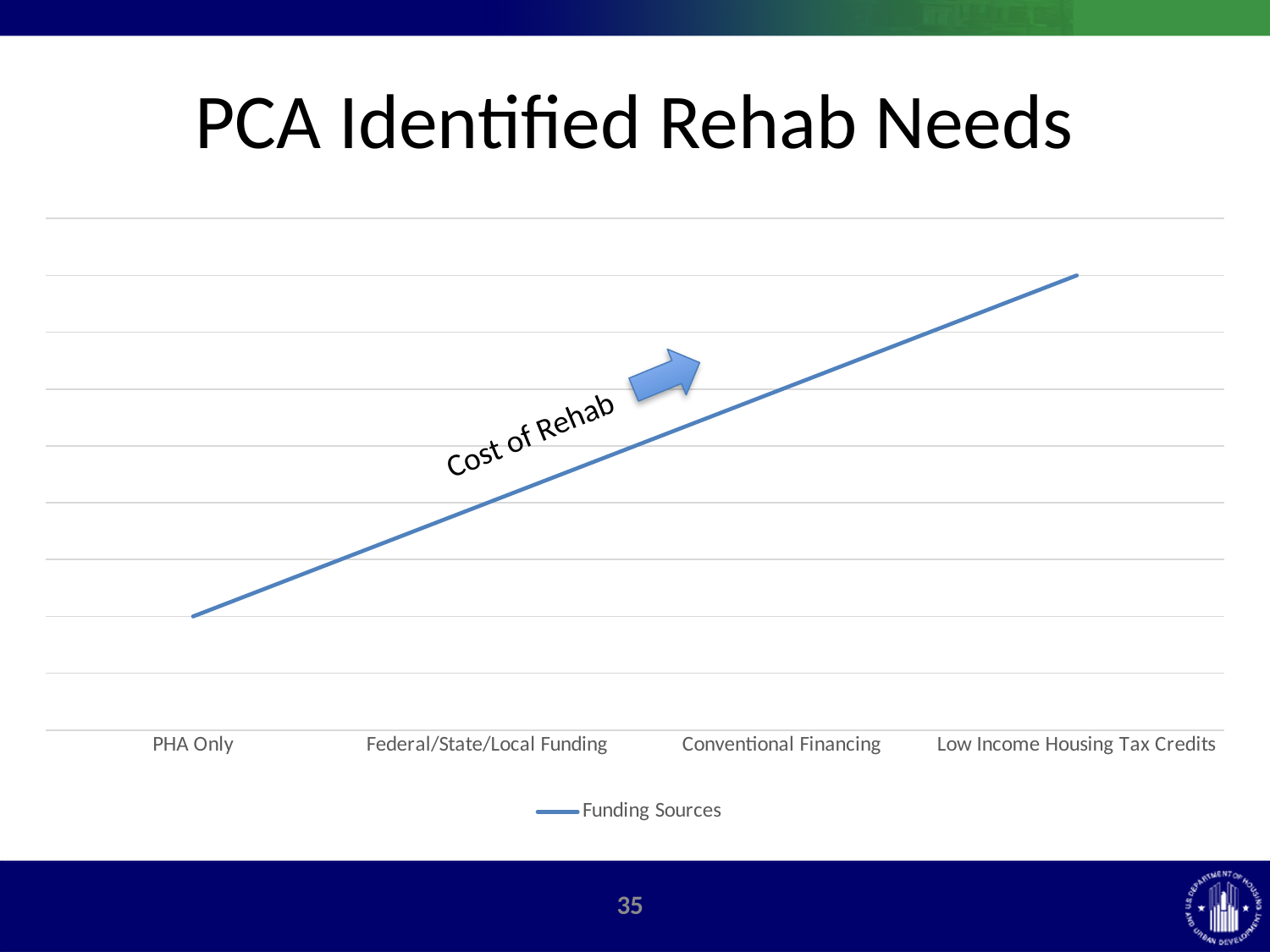
Which category has the lowest value on the Funding Sources line? PHA Only How many series does the chart's legend list? 1 What is the last category label on the x axis of the chart? Low Income Housing Tax Credits How many categories are shown along the x axis of the chart? 4 Which has the larger value on the Funding Sources line, PHA Only or Low Income Housing Tax Credits? Low Income Housing Tax Credits Which has the larger value on the Funding Sources line, Conventional Financing or Federal/State/Local Funding? Conventional Financing Which category has the highest value on the Funding Sources line? Low Income Housing Tax Credits Do the values of the Funding Sources line rise or fall from left to right along the x axis? rise What is the name of the series listed in the chart's legend? Funding Sources What is the first category label on the x axis of the chart? PHA Only What kind of chart is shown on the slide? line chart